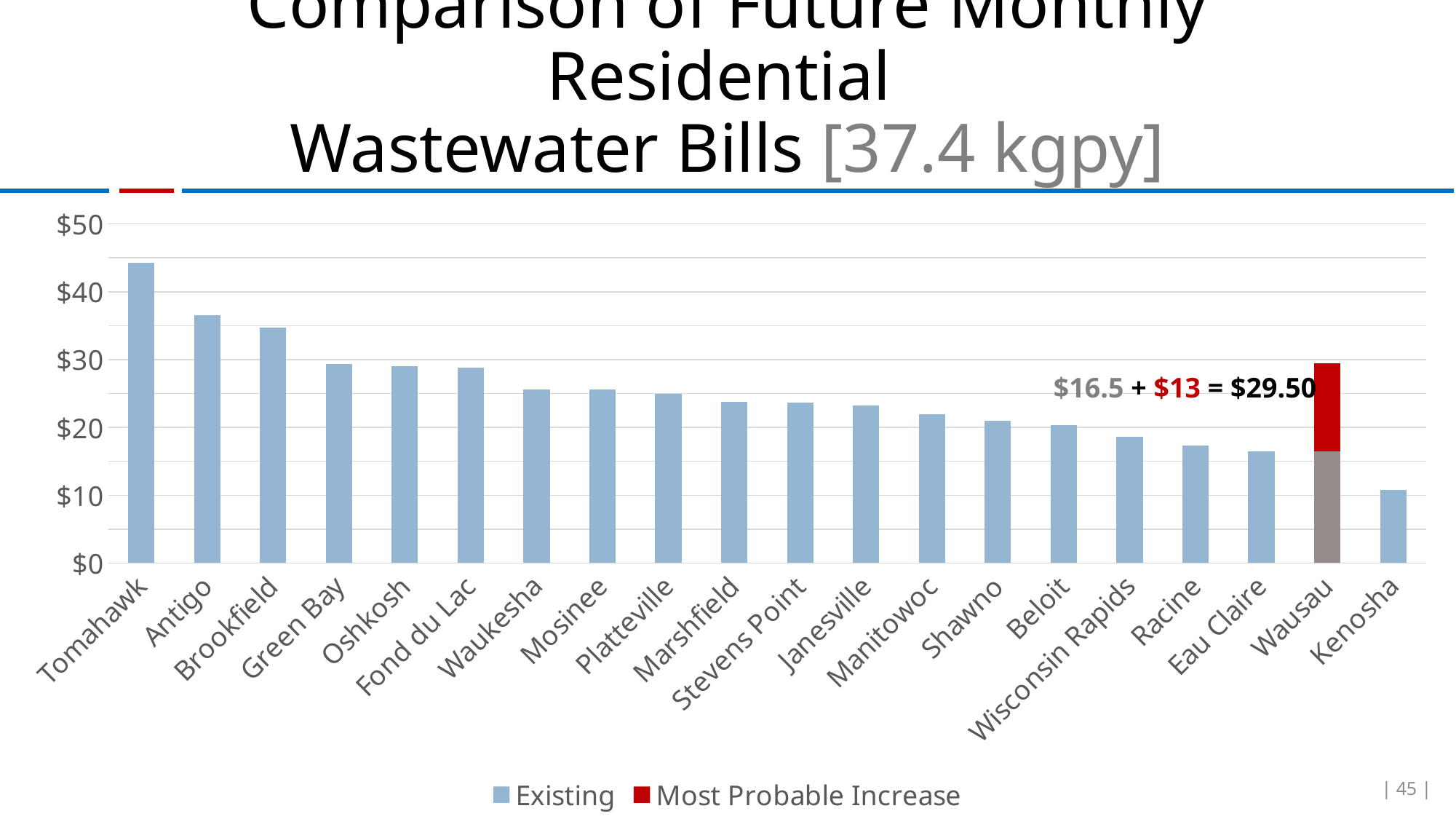
Is the value for Eau Claire greater or less than $20? less How many cities are shown on the x axis? 20 Which is larger, the bill for Tomahawk or the bill for Antigo? Tomahawk What is the existing monthly bill for Wausau? $16.5 What is the most probable increase for Wausau? $13 How many series does the legend list? 2 What kind of chart is shown on the slide? bar chart Is the value for Tomahawk greater or less than $40? greater Which city has the lowest monthly wastewater bill? Kenosha What is the total future monthly bill for Wausau? $29.50 What colour represents the Most Probable Increase series in the legend? red Which city has the highest monthly wastewater bill? Tomahawk